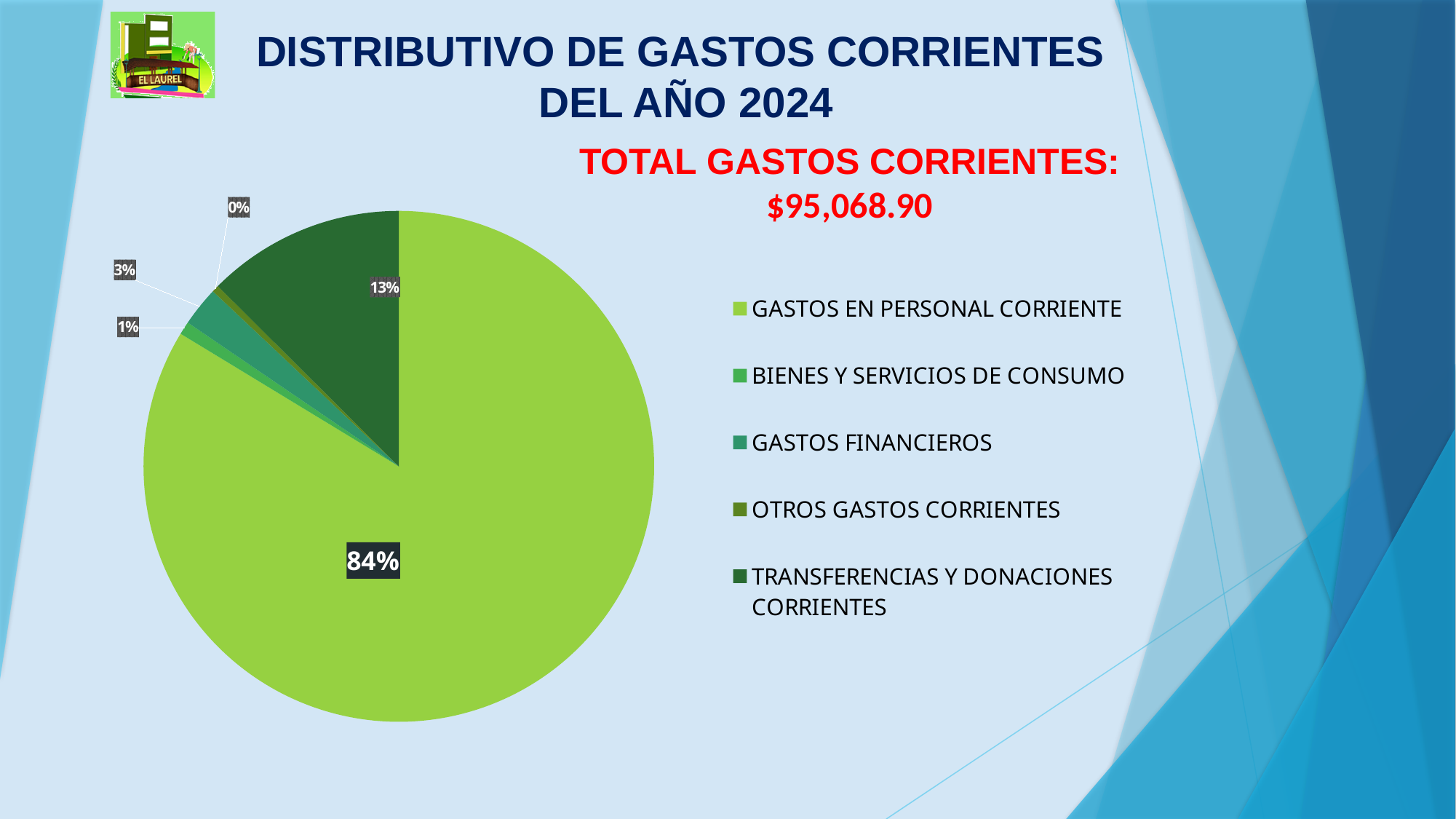
What percentage of the pie is TRANSFERENCIAS Y DONACIONES CORRIENTES? 13% What percentage of the pie is GASTOS EN PERSONAL CORRIENTE? 84% What percentage of the pie is GASTOS FINANCIEROS? 3% How many categories does the legend of the pie chart list? 5 What kind of chart is shown on the slide? pie chart What total amount of current expenses is stated on the slide? $95,068.90 Which category has the largest share of the pie? GASTOS EN PERSONAL CORRIENTE Which is larger, the share for GASTOS FINANCIEROS or the share for BIENES Y SERVICIOS DE CONSUMO? GASTOS FINANCIEROS What is the difference in percentage points between GASTOS EN PERSONAL CORRIENTE and TRANSFERENCIAS Y DONACIONES CORRIENTES? 71 What percentage of the pie is BIENES Y SERVICIOS DE CONSUMO? 1% What percentage of the pie is OTROS GASTOS CORRIENTES? 0% Which category has the smallest share of the pie? OTROS GASTOS CORRIENTES